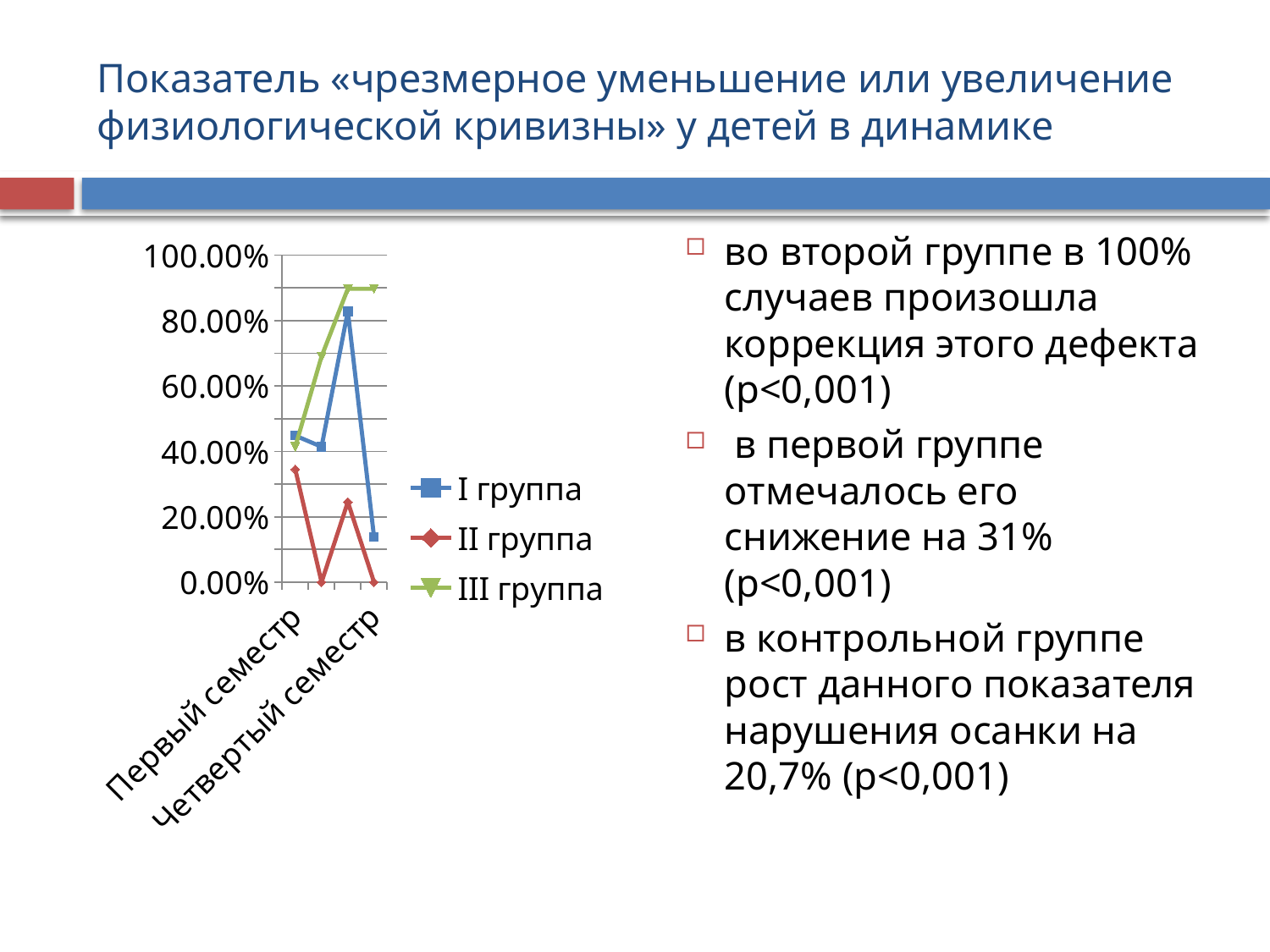
Is the value for I группа at Четвертый семестр greater or less than 20.00%? less Is the value for I группа at Первый семестр greater or less than 60.00%? less Is the value for III группа at Четвертый семестр greater or less than 80.00%? greater Which series has the highest value at Четвертый семестр? III группа At Четвертый семестр, which is larger: the value for I группа or for III группа? III группа Does the value for III группа rise or fall from Первый семестр to Четвертый семестр? rise What is the value for II группа at Четвертый семестр? 0.00% What kind of chart is shown on the slide? line chart Which series has the lowest value at Четвертый семестр? II группа How many series does the chart legend list? 3 Which series are listed in the chart legend? I группа, II группа, III группа